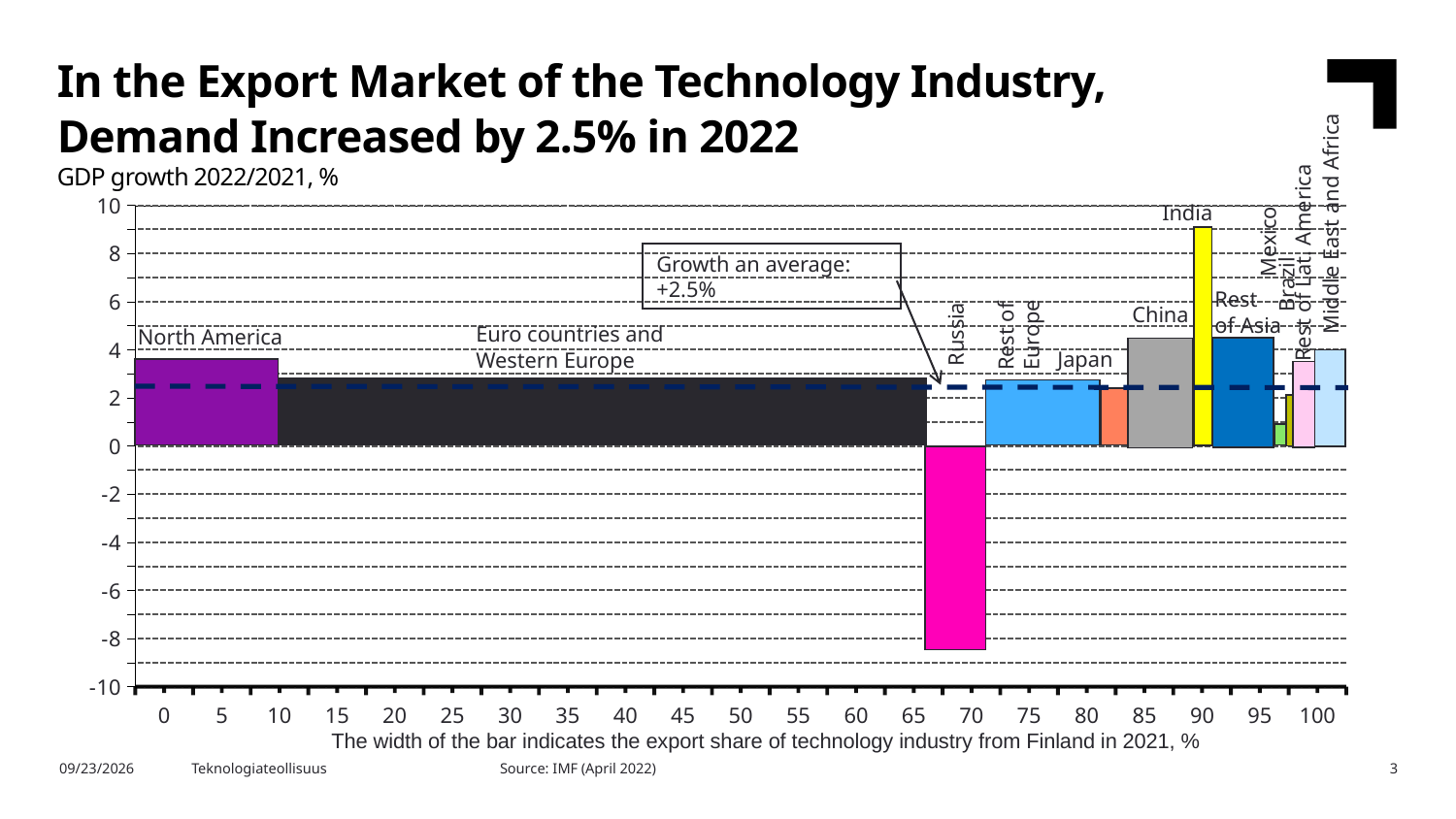
Which has higher GDP growth, India or China? India What type of chart is shown on the slide? bar chart Is the GDP growth value for India greater or less than 8? greater How many regions (bars) are plotted in the chart? 12 Which region has the highest GDP growth in the chart? India Is the GDP growth value for Russia greater or less than -5? less What is the average growth shown in the annotation box? +2.5% According to the note below the x axis, what does the width of each bar indicate? The export share of technology industry from Finland in 2021, % Is the GDP growth value for Brazil greater or less than 2? less Which has higher GDP growth, Russia or Japan? Japan Which region has the lowest GDP growth in the chart? Russia